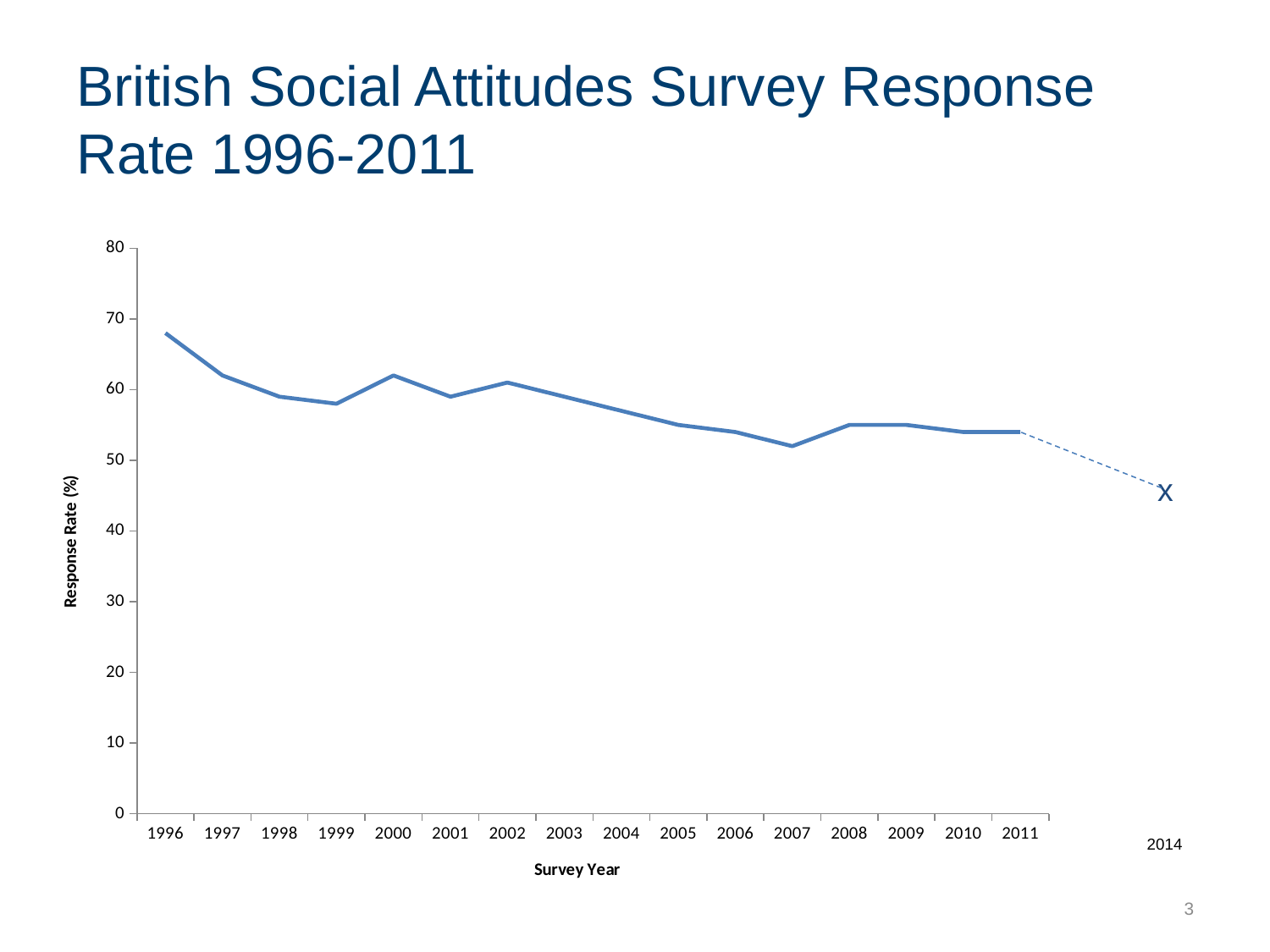
Is the response rate for 2007 greater or less than 50? greater How many survey years are plotted on the solid line? 16 Which year has a higher response rate, 1996 or 2011? 1996 Which year has a higher response rate, 2000 or 2007? 2000 Which survey year has the highest response rate? 1996 Is the response rate for 2004 greater or less than 60? less Is the response rate for 1996 greater or less than 70? less Overall, does the response rate rise or fall from 1996 to 2011? Fall What kind of chart is shown on the slide? Line chart What is the title of the vertical axis? Response Rate (%) Which survey year has the lowest response rate on the solid line? 2007